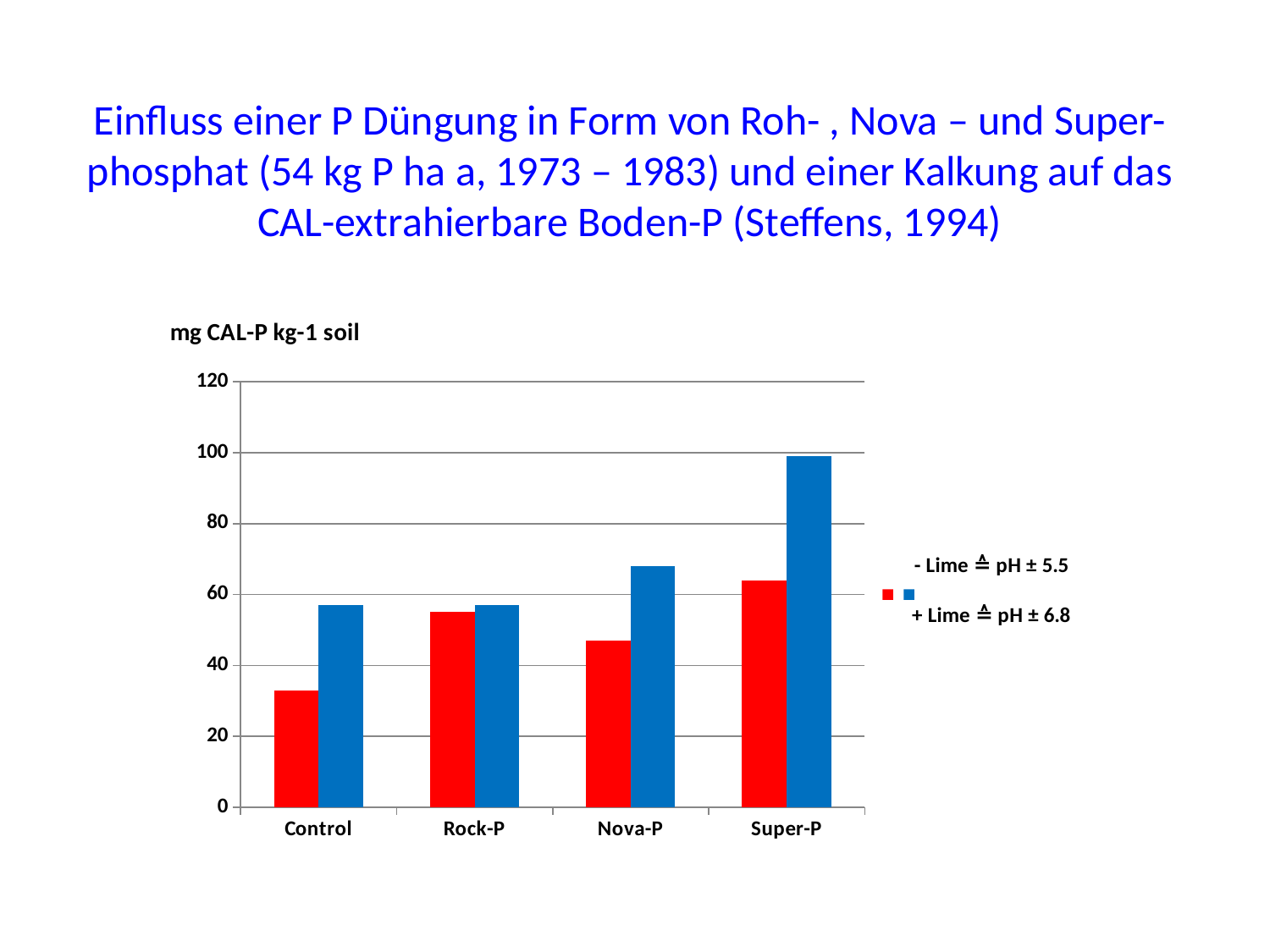
For Control, which series has the larger value: - Lime (pH ± 5.5) or + Lime (pH ± 6.8)? + Lime (pH ± 6.8) Which category has the highest value for the + Lime (pH ± 6.8) series? Super-P Which is larger: the - Lime (pH ± 5.5) value for Super-P or for Nova-P? Super-P How many categories are shown on the x axis of the chart? 4 How many series does the chart's legend list? 2 Is the + Lime (pH ± 6.8) value for Super-P greater or less than 80? greater Is the - Lime (pH ± 5.5) value for Control greater or less than 40? less What is the label shown above the y axis of the chart? mg CAL-P kg-1 soil Which category has the highest value for the - Lime (pH ± 5.5) series? Super-P What kind of chart is shown on the slide? bar chart Is the + Lime (pH ± 6.8) value for Nova-P greater or less than 60? greater Which category has the lowest value for the - Lime (pH ± 5.5) series? Control